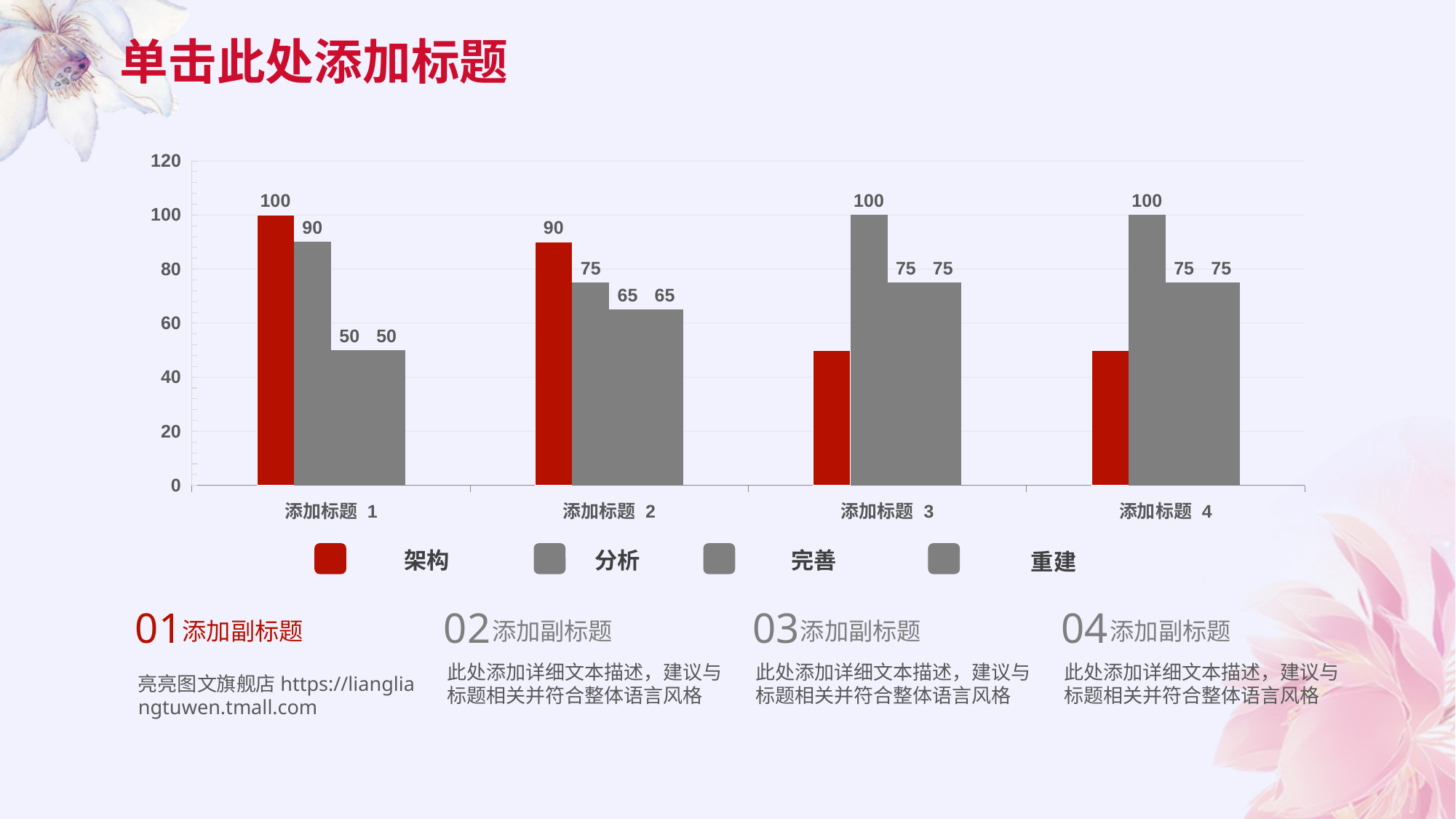
What is the value of 完善 for 添加标题 3? 75 What is the difference between 架构 and 完善 for 添加标题 2? 25 What is the value of 架构 for 添加标题 1? 100 Which series is shown in red in the legend? 架构 Which category has the lowest value for 分析? 添加标题 2 How many series does the legend list? 4 What kind of chart is shown on the slide? bar chart What is the value of 重建 for 添加标题 1? 50 Is the value of 架构 for 添加标题 3 greater or less than 80? less Which category has the highest value for 架构? 添加标题 1 What is the value of 分析 for 添加标题 2? 75 How many categories are shown on the x axis? 4